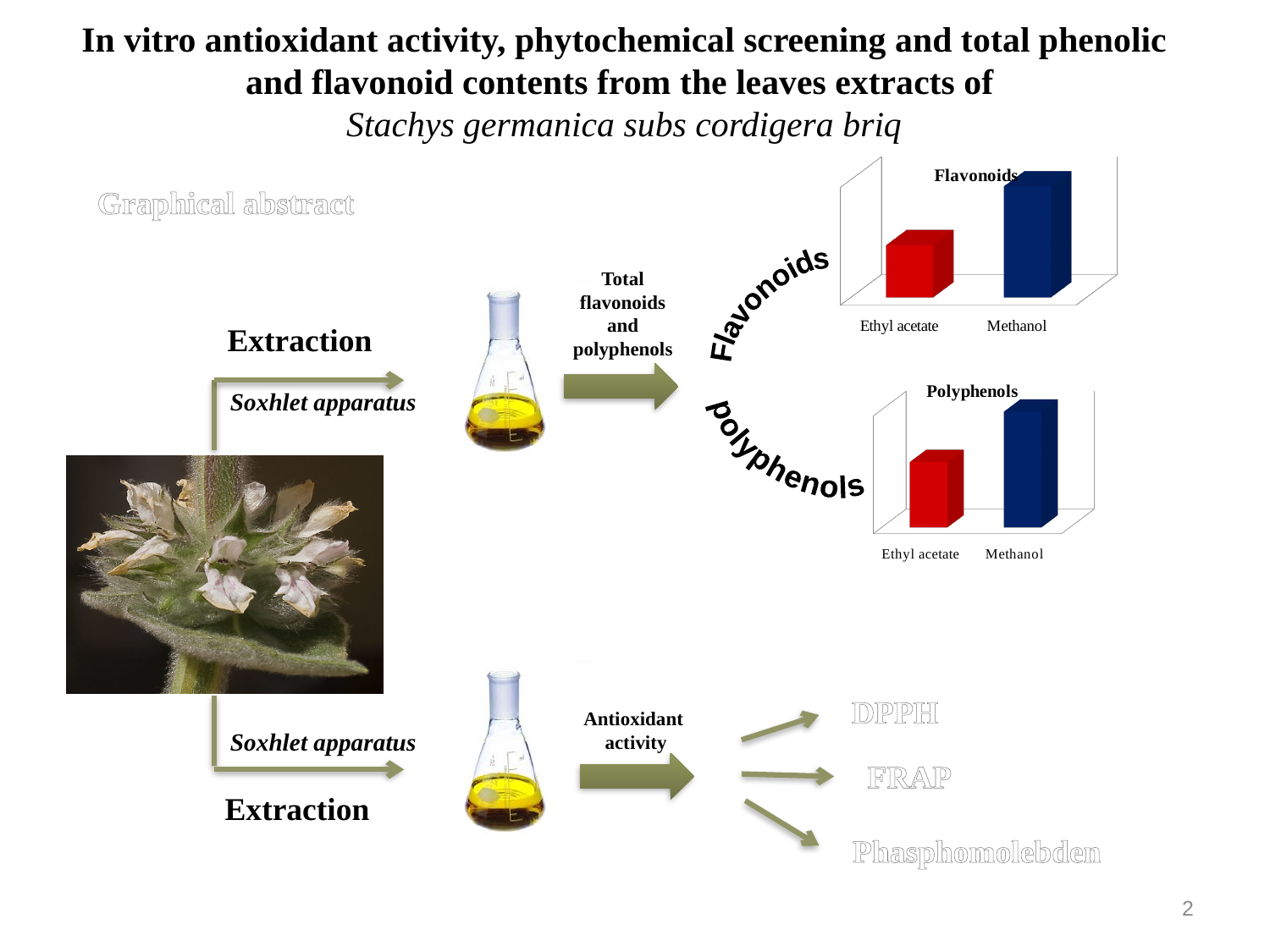
What is the title of the lower chart on the right side of the slide? Polyphenols In the Flavonoids chart, which category has the lowest bar? Ethyl acetate How many categories are shown in the Polyphenols chart? 2 In the Polyphenols chart, is the bar for Ethyl acetate larger or smaller than the bar for Methanol? smaller In the Polyphenols chart, which category has the highest bar? Methanol What kind of chart is the Polyphenols chart? bar chart In the Flavonoids chart, what colour is the bar for Methanol? blue What kind of chart is the Flavonoids chart? bar chart In the Flavonoids chart, which category has the highest bar? Methanol In the Polyphenols chart, which category has the lowest bar? Ethyl acetate How many categories are shown in the Flavonoids chart? 2 In the Flavonoids chart, is the bar for Methanol larger or smaller than the bar for Ethyl acetate? larger